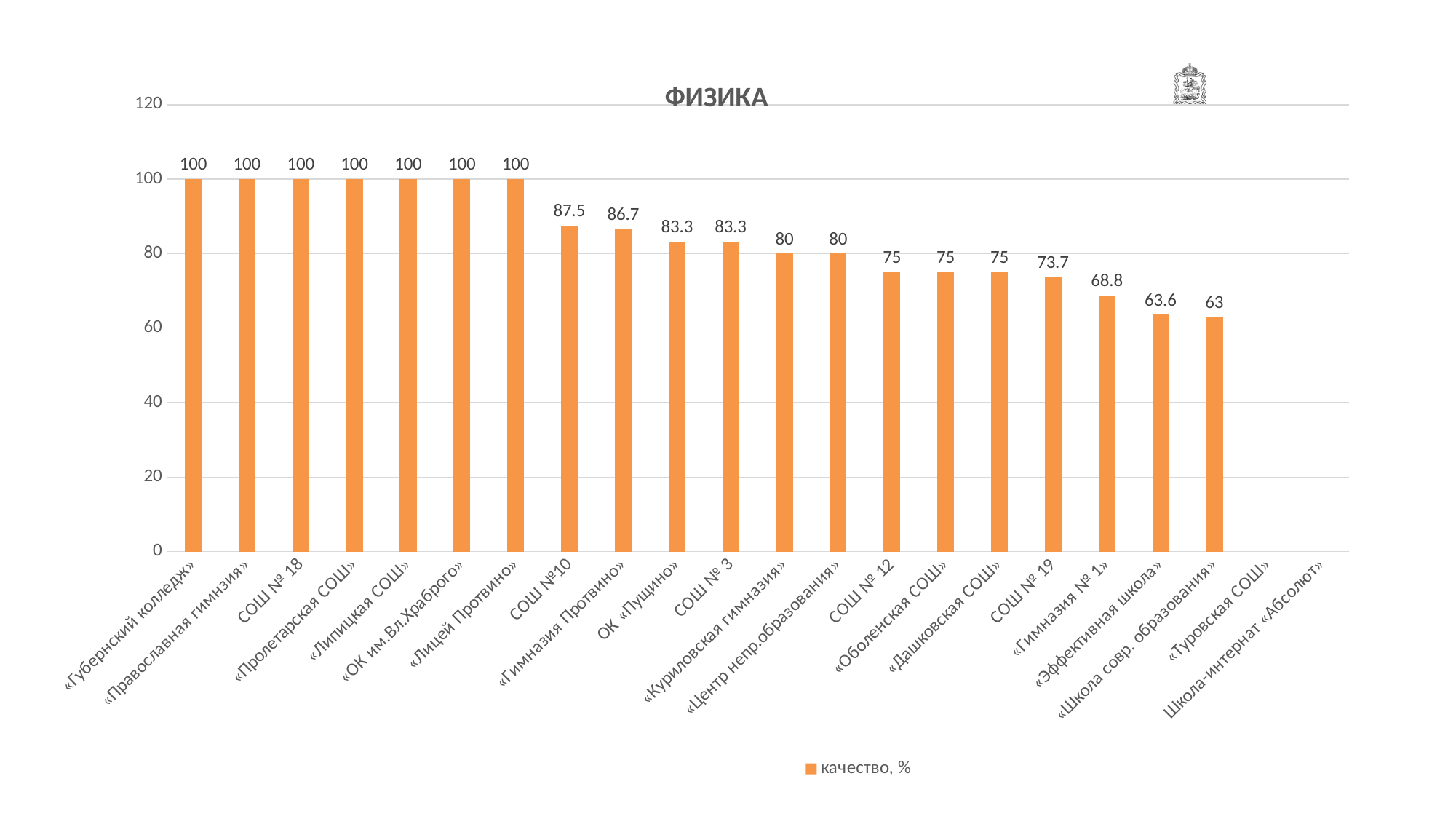
What is the value for СОШ №10? 87.5 What kind of chart is shown on the slide? bar chart What is the difference between the values for СОШ №10 and «Гимназия Протвино»? 0.8 How many series does the legend list? 1 Is the value for СОШ № 19 greater or less than 80? less What is the value for «Гимназия № 1»? 68.8 Which category has the lowest plotted value? «Школа совр. образования» Do the values rise or fall from left to right along the x axis? fall What is the difference between the values for «Губернский колледж» and «Школа совр. образования»? 37 How many categories are labelled on the x axis? 22 Which is larger, the value for ОК «Пущино» or the value for «Центр непр.образования»? ОК «Пущино» What is the value for «Эффективная школа»? 63.6